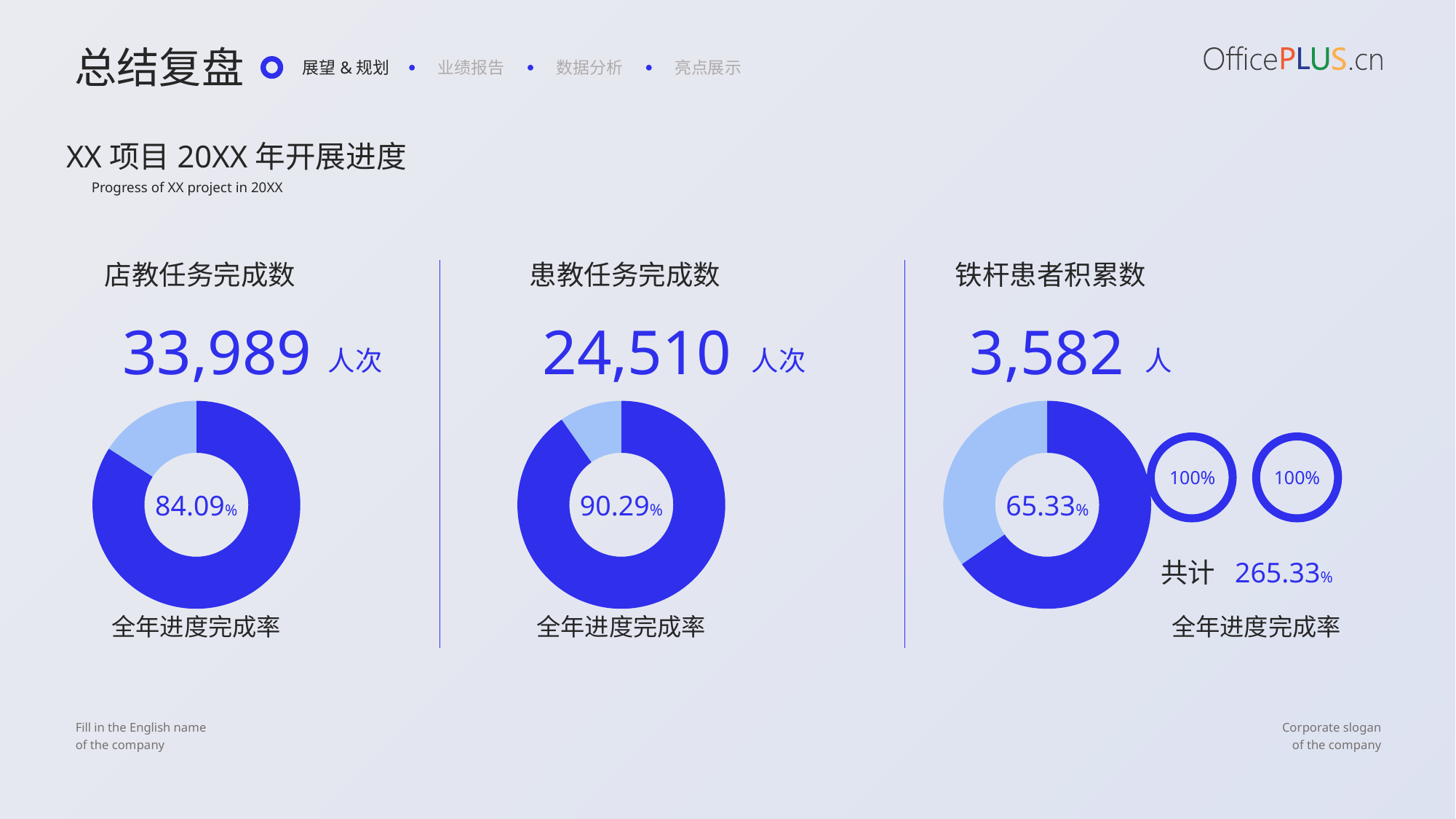
What completion rate is shown in the centre of the large 铁杆患者积累数 donut chart? 65.33% Which of the three sections (店教任务完成数, 患教任务完成数, 铁杆患者积累数) shows the highest 全年进度完成率 in its large donut chart? 患教任务完成数 What headline figure is shown above the 铁杆患者积累数 donut chart? 3,582 人 What completion rate is shown in the centre of the 店教任务完成数 donut chart? 84.09% What completion rate is shown in the centre of the 患教任务完成数 donut chart? 90.29% What is the difference between the completion rate in the 患教任务完成数 donut chart and the 店教任务完成数 donut chart? 6.20% What 共计 (total) percentage is shown in the 铁杆患者积累数 section? 265.33% Is the completion rate in the 店教任务完成数 donut chart larger or smaller than the one in the 铁杆患者积累数 large donut chart? larger What kind of chart is used to show the 全年进度完成率 in each section? Donut chart Which of the three sections (店教任务完成数, 患教任务完成数, 铁杆患者积累数) shows the lowest 全年进度完成率 in its large donut chart? 铁杆患者积累数 What value is shown in each of the two small ring charts in the 铁杆患者积累数 section? 100% How many donut or ring charts are shown on the slide in total? 5